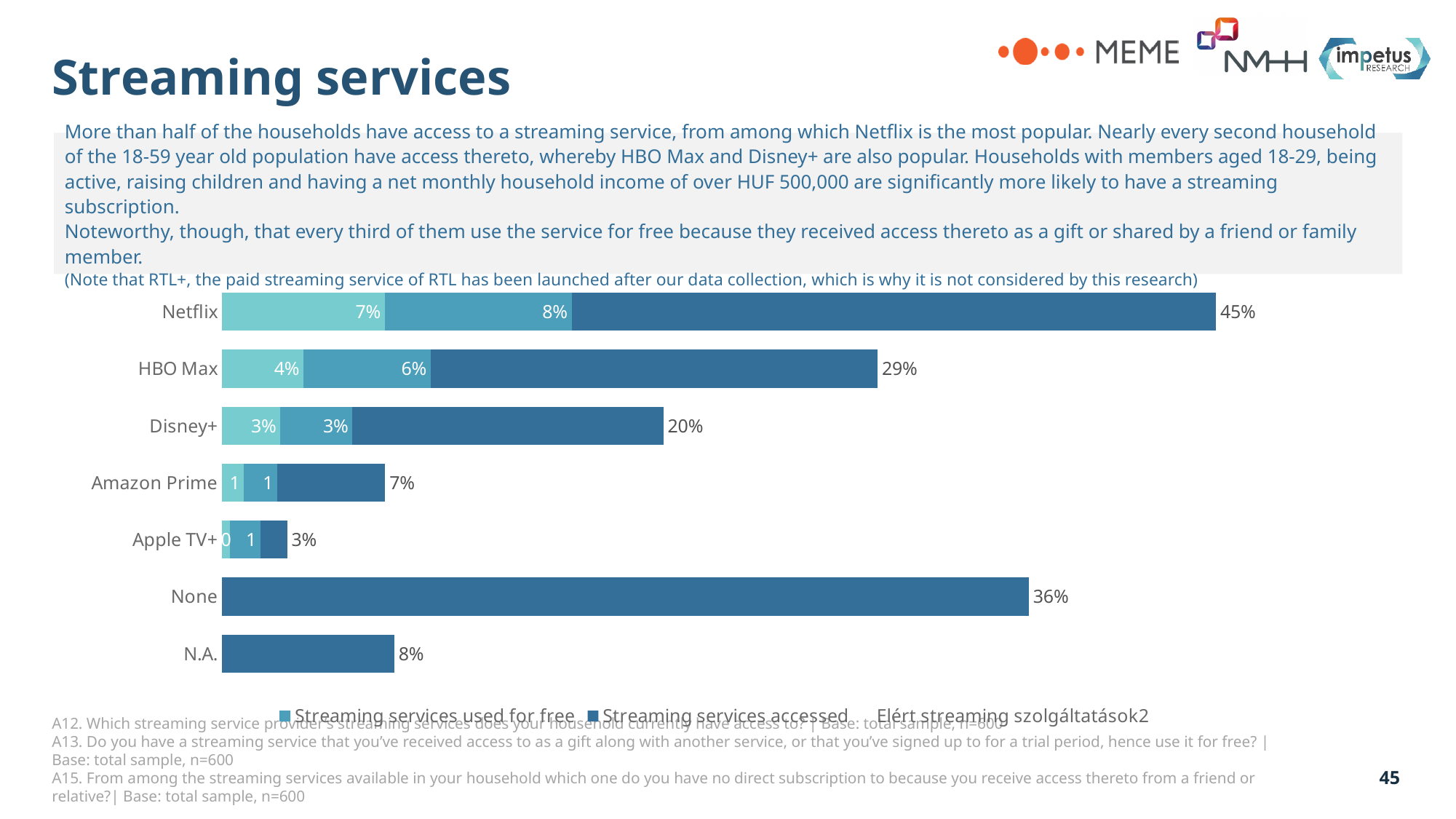
What kind of chart is shown on the slide? bar chart What is the value printed at the end of the Disney+ bar? 20% How many series does the chart legend list? 3 How many categories are listed on the vertical axis of the chart? 7 What is the difference between the end-of-bar values for Netflix and HBO Max? 16 percentage points What is the value printed at the end of the None bar? 36% Which streaming service has the shortest bar in the chart? Apple TV+ Which has the larger end-of-bar value, None or HBO Max? None What is the value printed at the end of the Netflix bar? 45% Which category has the longest bar in the chart? Netflix What is the value printed at the end of the N.A. bar? 8% What is the value printed at the end of the HBO Max bar? 29%